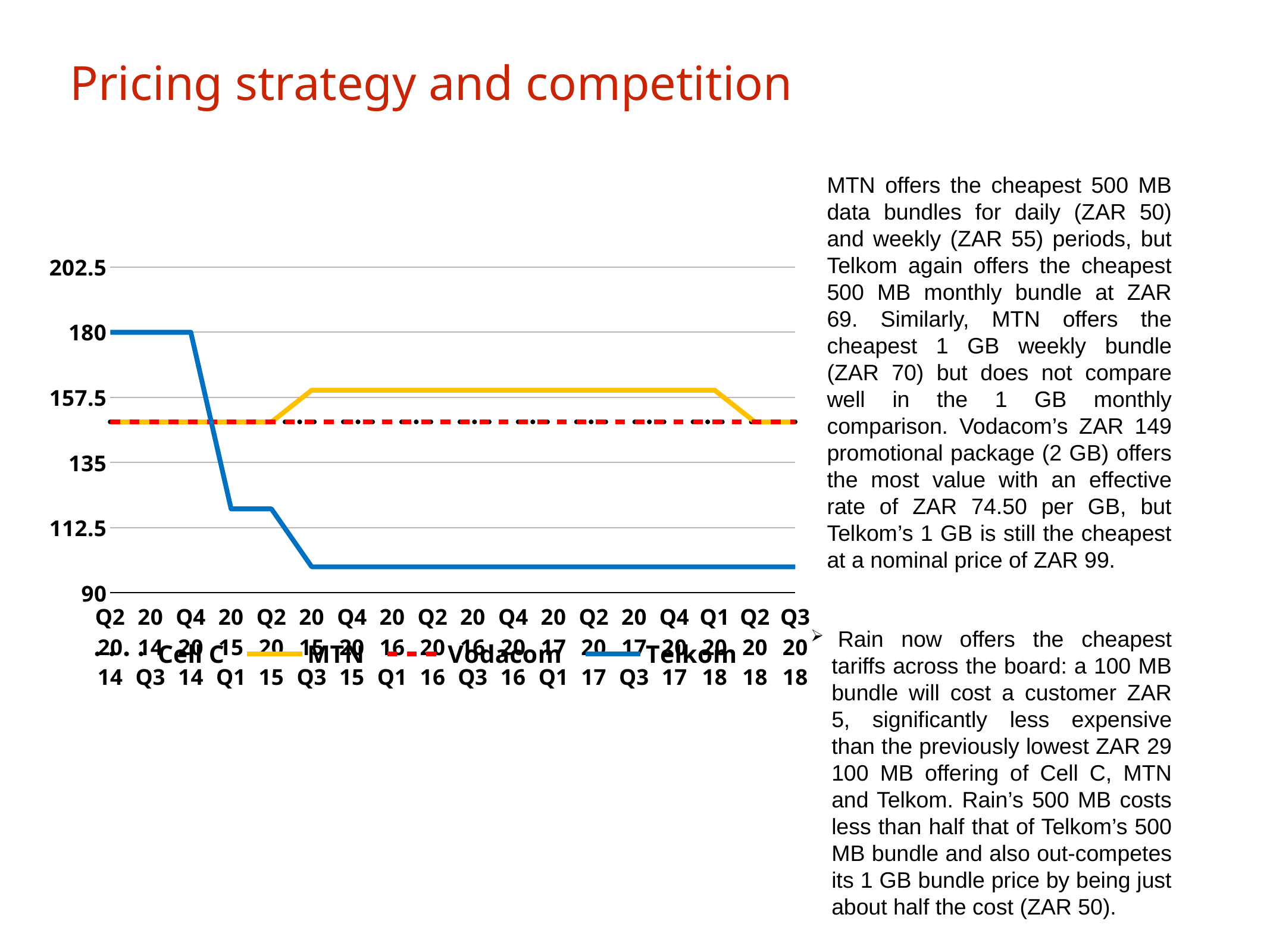
Is the value for Telkom in Q3 2018 greater or less than 112.5? less Is the value for Telkom in Q2 2014 greater or less than 157.5? greater In Q2 2014, which is larger: the value for Telkom or the value for MTN? Telkom Is the value for MTN in Q2 2016 greater or less than 157.5? greater How many series does the chart legend list? 4 What kind of chart is shown on the slide? line chart Which series has the highest value in Q2 2017? MTN Does the Telkom line rise or fall from Q2 2014 to Q3 2018? fall How many quarters are plotted along the x axis of the chart? 18 Which series is plotted with a dashed red line? Vodacom Which series has the lowest value in Q2 2017? Telkom